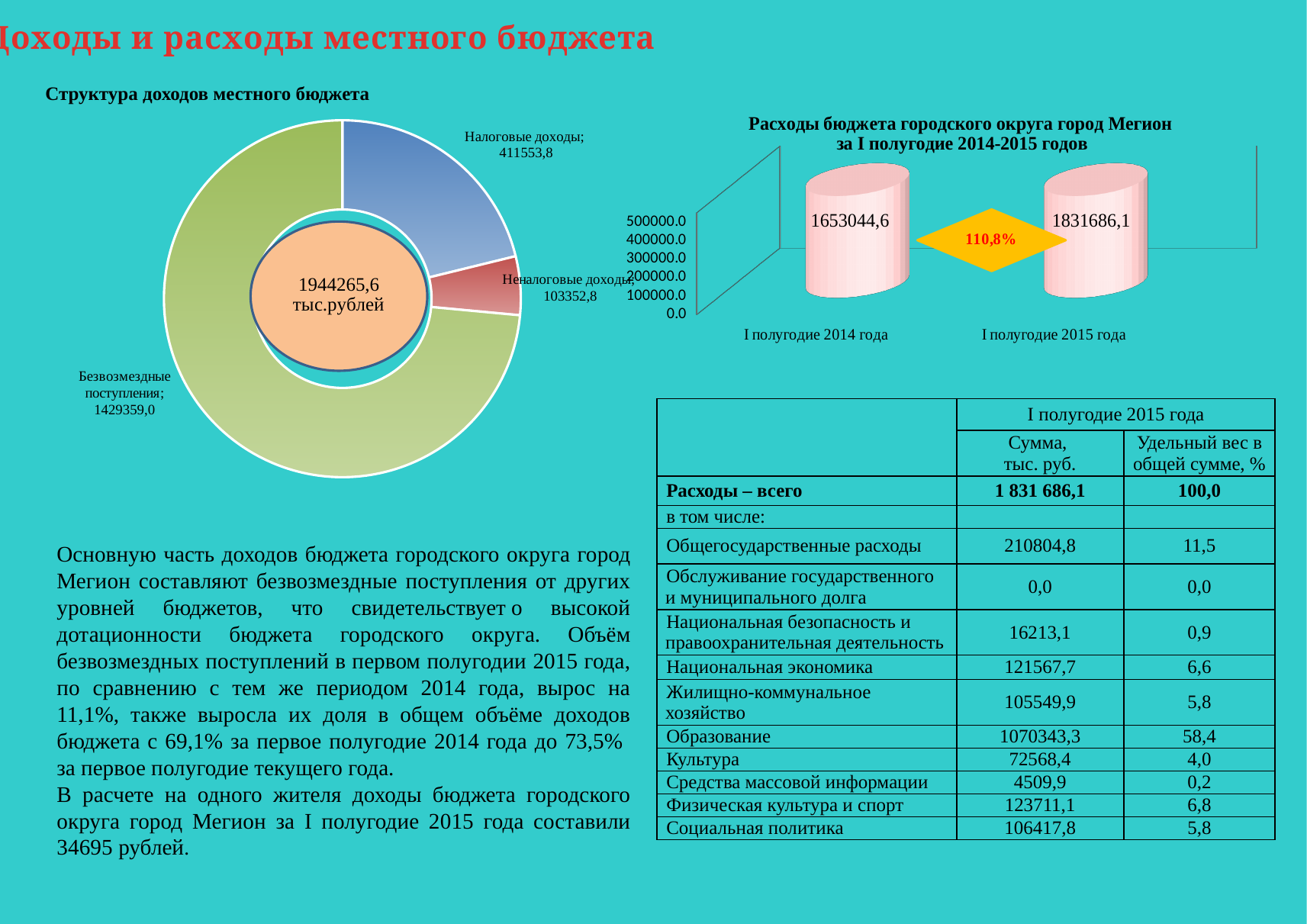
On the chart 'Структура доходов местного бюджета', what is the value for Налоговые доходы? 411553,8 On the chart 'Расходы бюджета городского округа город Мегион за I полугодие 2014-2015 годов', what is the value for I полугодие 2014 года? 1653044,6 On the chart 'Структура доходов местного бюджета', what is the value for Безвозмездные поступления? 1429359,0 On the chart 'Расходы бюджета городского округа город Мегион за I полугодие 2014-2015 годов', what is the difference between I полугодие 2015 года and I полугодие 2014 года? 178641,5 On the chart 'Структура доходов местного бюджета', how many categories are shown? 3 On the chart 'Структура доходов местного бюджета', what total is printed in the centre of the chart? 1944265,6 тыс.рублей On the chart 'Расходы бюджета городского округа город Мегион за I полугодие 2014-2015 годов', do the values rise or fall from 2014 to 2015? rise On the chart 'Расходы бюджета городского округа город Мегион за I полугодие 2014-2015 годов', what percentage is printed between the two bars? 110,8% On the chart 'Структура доходов местного бюджета', which category has the smallest value? Неналоговые доходы On the chart 'Структура доходов местного бюджета', which category has the largest value? Безвозмездные поступления On the chart 'Структура доходов местного бюджета', what is the difference between Налоговые доходы and Неналоговые доходы? 308201,0 On the chart 'Расходы бюджета городского округа город Мегион за I полугодие 2014-2015 годов', what is the value for I полугодие 2015 года? 1831686,1